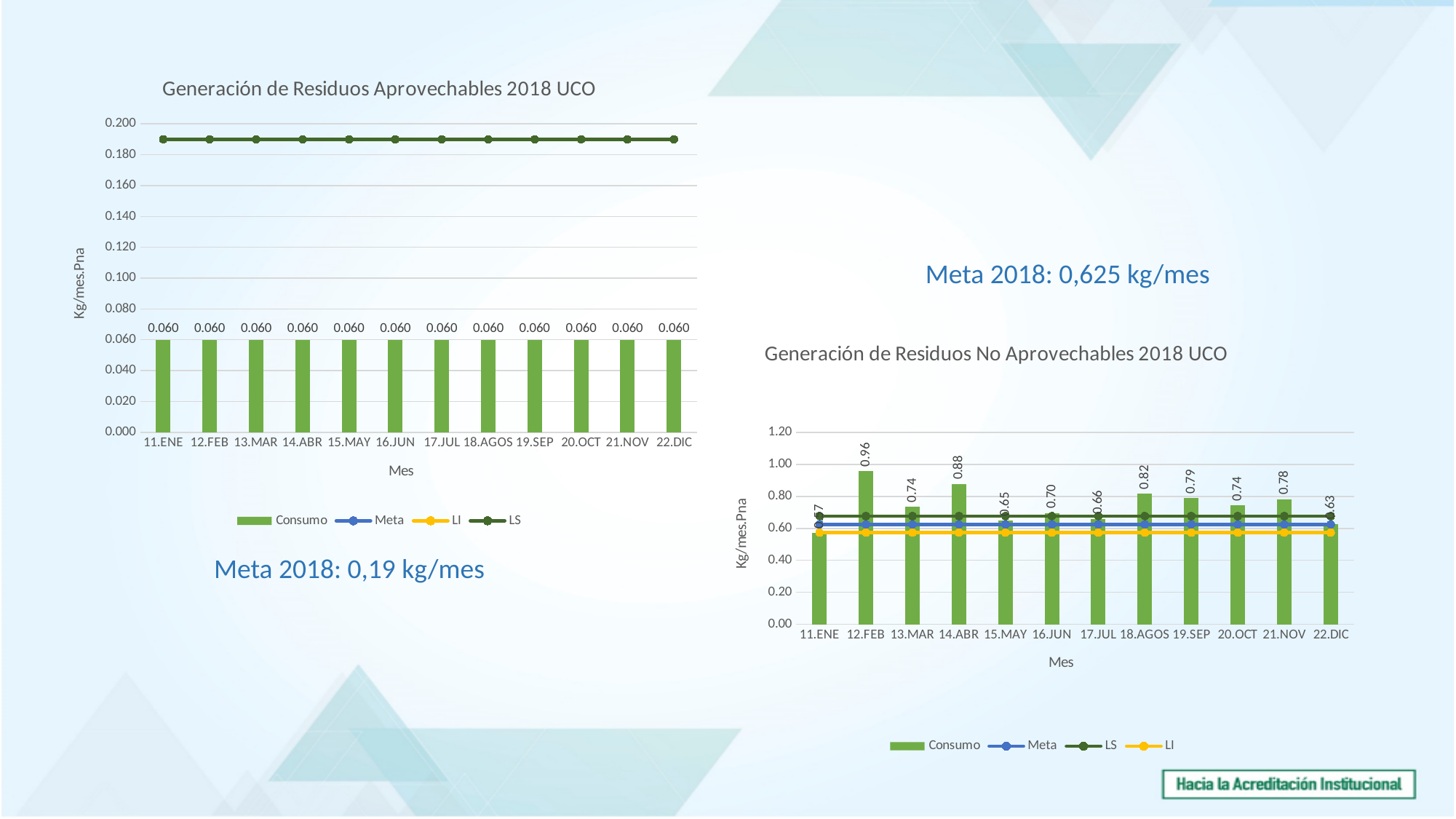
In the chart titled 'Generación de Residuos No Aprovechables 2018 UCO', what is the Consumo value for 18.AGOS? 0.82 In the chart titled 'Generación de Residuos No Aprovechables 2018 UCO', which month has the highest Consumo value? 12.FEB How many series does the legend list in the chart titled 'Generación de Residuos Aprovechables 2018 UCO'? 4 In the chart titled 'Generación de Residuos Aprovechables 2018 UCO', is the LS line greater or less than 0.180? greater In the chart titled 'Generación de Residuos Aprovechables 2018 UCO', what is the Consumo value for 14.ABR? 0.060 In the chart titled 'Generación de Residuos No Aprovechables 2018 UCO', what is the Consumo value for 12.FEB? 0.96 In the chart titled 'Generación de Residuos No Aprovechables 2018 UCO', which month has the lowest Consumo bar? 11.ENE What kind of chart is used for the Consumo series in the chart titled 'Generación de Residuos Aprovechables 2018 UCO'? Bar chart In the chart titled 'Generación de Residuos Aprovechables 2018 UCO', do the Consumo values rise, fall or stay flat across the months? Stay flat In the chart titled 'Generación de Residuos No Aprovechables 2018 UCO', which is larger, the Consumo value for 19.SEP or for 16.JUN? 19.SEP In the chart titled 'Generación de Residuos No Aprovechables 2018 UCO', what is the difference between the Consumo values for 12.FEB and 14.ABR? 0.08 How many months are shown on the x axis of the chart titled 'Generación de Residuos No Aprovechables 2018 UCO'? 12